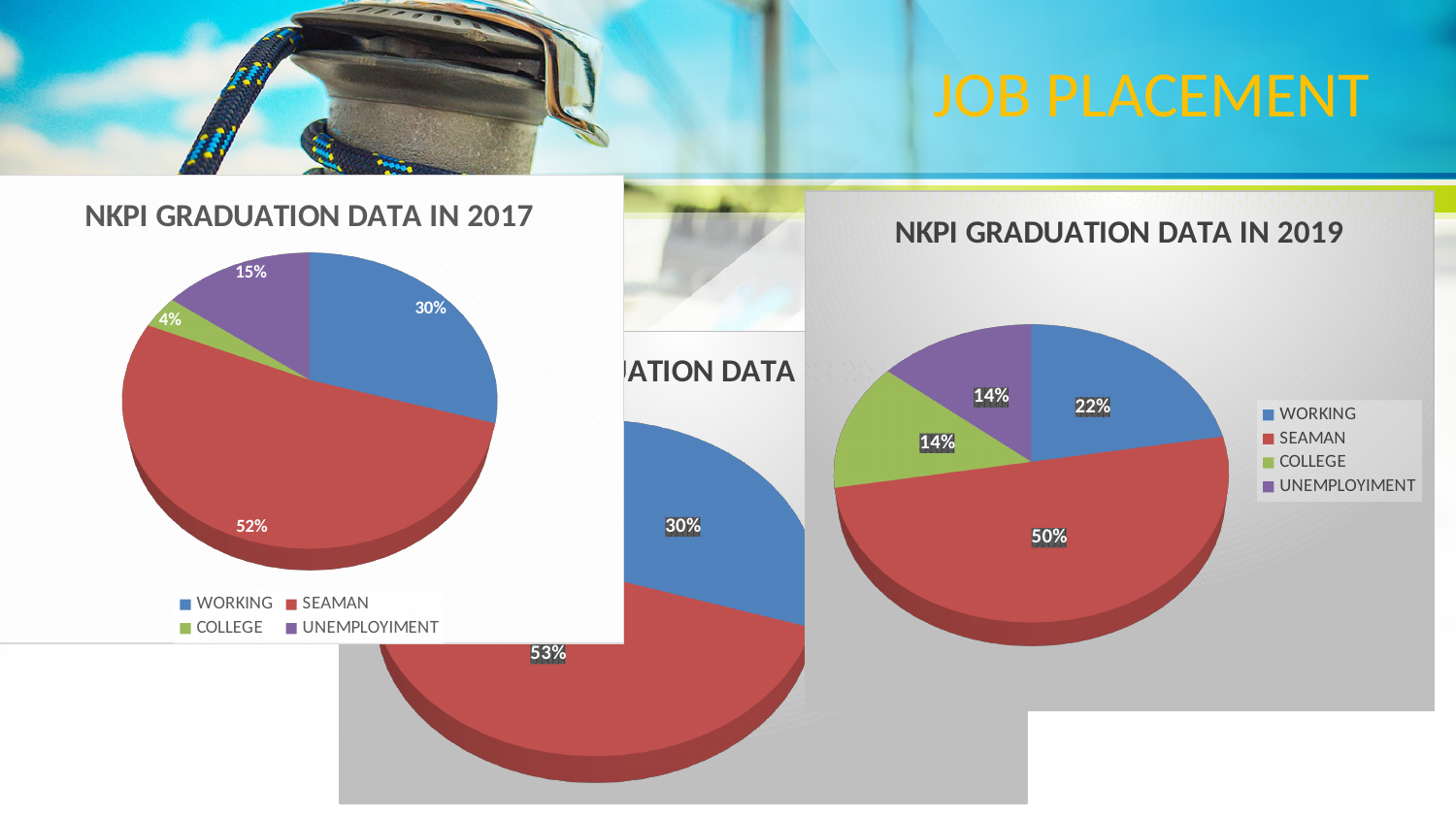
In the chart titled "NKPI GRADUATION DATA IN 2019", which category has the largest slice? SEAMAN In the chart titled "NKPI GRADUATION DATA IN 2017", what percentage is shown for SEAMAN? 52% In the chart titled "NKPI GRADUATION DATA IN 2017", what percentage is shown for COLLEGE? 4% In the chart titled "NKPI GRADUATION DATA IN 2017", which is larger, UNEMPLOYIMENT or COLLEGE? UNEMPLOYIMENT In the chart titled "NKPI GRADUATION DATA IN 2019", what percentage is shown for WORKING? 22% In the chart titled "NKPI GRADUATION DATA IN 2019", what percentage is shown for SEAMAN? 50% In the chart titled "NKPI GRADUATION DATA IN 2019", how many percentage points larger is SEAMAN than WORKING? 28% How many categories does the legend of the chart titled "NKPI GRADUATION DATA IN 2019" list? 4 What kind of chart is "NKPI GRADUATION DATA IN 2019"? Pie chart In the chart titled "NKPI GRADUATION DATA IN 2017", which category has the smallest slice? COLLEGE In the chart titled "NKPI GRADUATION DATA IN 2017", how many percentage points larger is SEAMAN than WORKING? 22% In the chart titled "NKPI GRADUATION DATA IN 2017", which category has the largest slice? SEAMAN